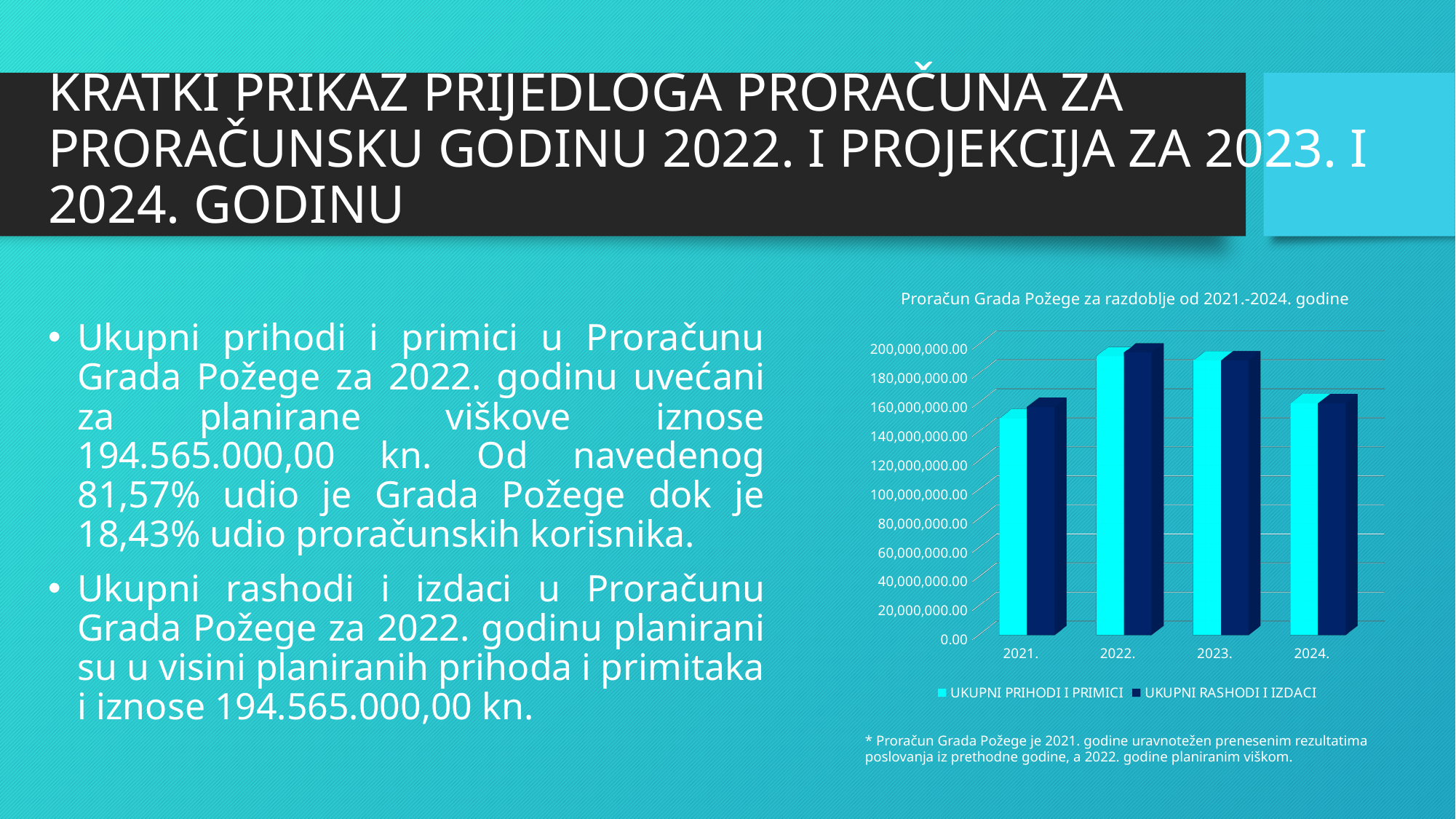
Is the value for UKUPNI RASHODI I IZDACI in 2024. greater or less than 140,000,000.00? greater Do the values for UKUPNI PRIHODI I PRIMICI rise or fall from 2022. to 2024.? fall Which is larger, the value for UKUPNI PRIHODI I PRIMICI in 2022. or in 2021.? 2022. Which series is shown in dark blue in the chart? UKUPNI RASHODI I IZDACI Is the value for UKUPNI PRIHODI I PRIMICI in 2021. greater or less than 180,000,000.00? less In which year is the value for UKUPNI PRIHODI I PRIMICI highest? 2022. How many years (categories) are shown on the x axis of the chart? 4 What is the title of the chart? Proračun Grada Požege za razdoblje od 2021.-2024. godine Is the value for UKUPNI RASHODI I IZDACI in 2023. greater or less than 160,000,000.00? greater What kind of chart is shown on the slide? bar chart How many series does the chart legend list? 2